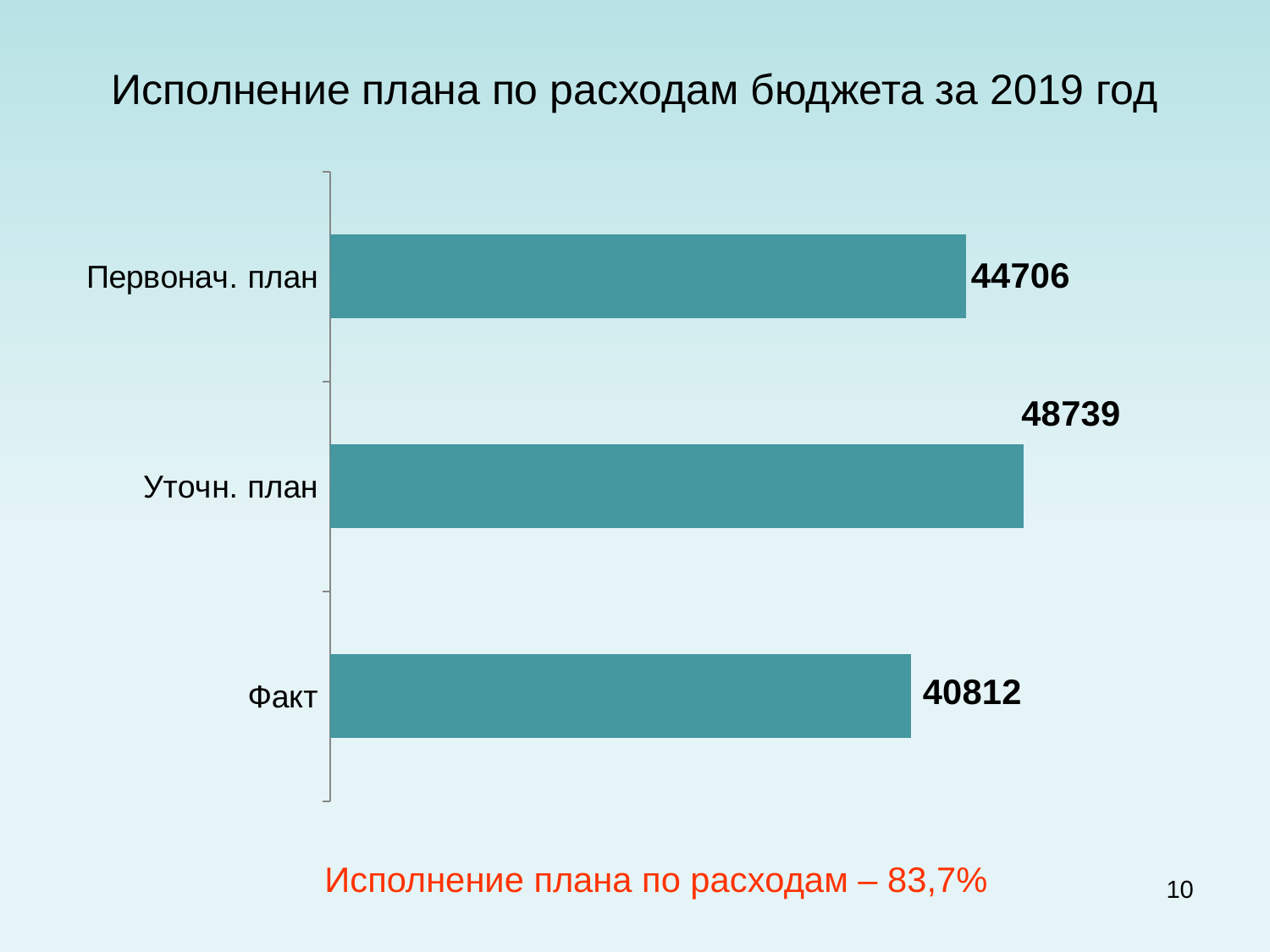
Which category has the lowest value? Факт What is the value for Уточн. план? 48739 What is the title of the slide? Исполнение плана по расходам бюджета за 2019 год What percentage of plan execution for expenditures is stated below the chart? 83,7% Which is larger, Первонач. план or Факт? Первонач. план What is the difference between Уточн. план and Факт? 7927 What is the value for Факт? 40812 What kind of chart is shown on the slide? bar chart How many categories are shown in the chart? 3 What is the difference between Уточн. план and Первонач. план? 4033 What is the value for Первонач. план? 44706 Which category has the highest value? Уточн. план